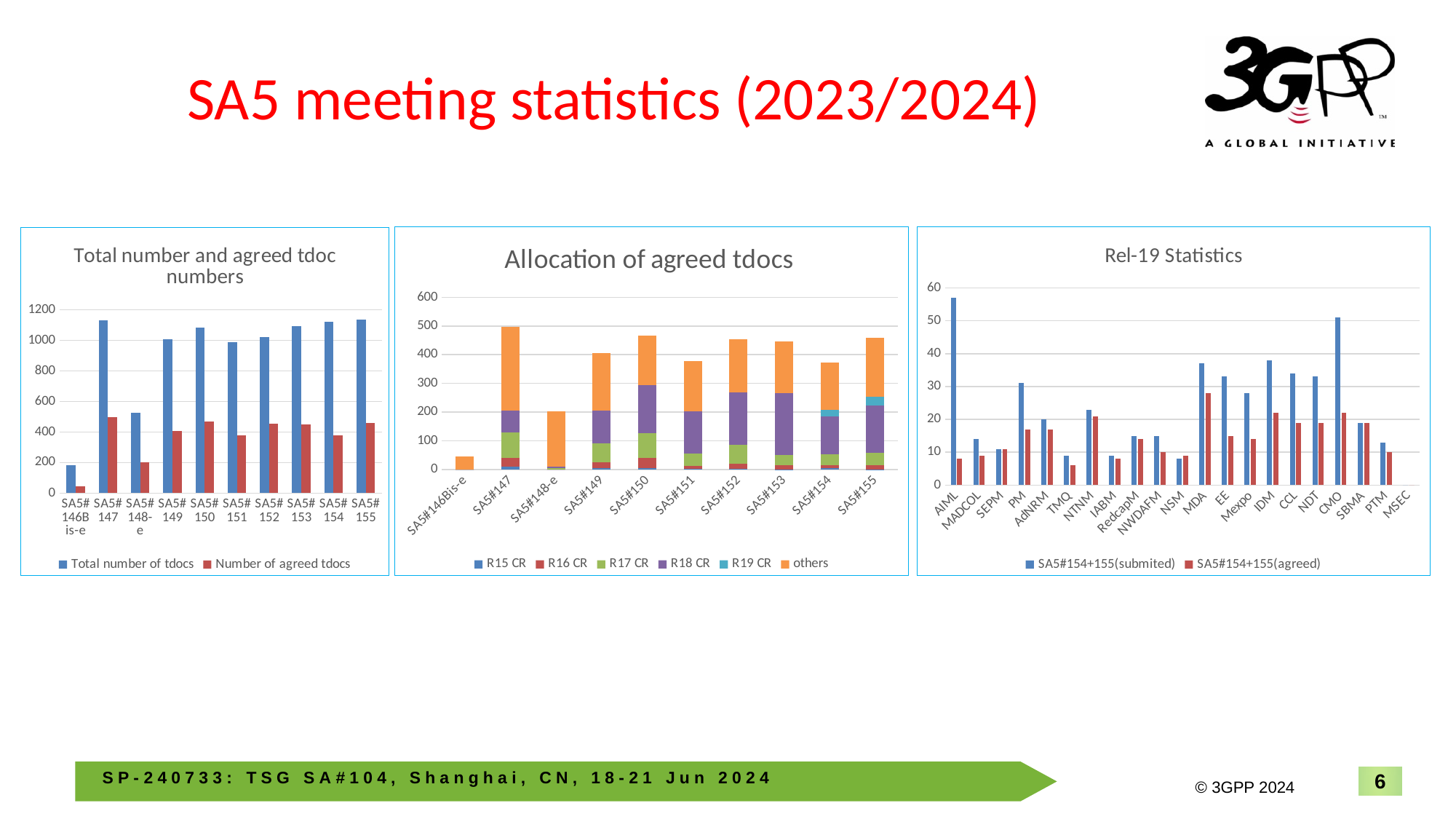
In the chart titled "Rel-19 Statistics", which category has the highest SA5#154+155(submited) value? AIML In the chart titled "Allocation of agreed tdocs", how many series does the legend list? 6 In the chart titled "Total number and agreed tdoc numbers", is the total number of tdocs for SA5#146Bis-e greater or less than 200? less In the chart titled "Allocation of agreed tdocs", which meeting has the lowest stacked total? SA5#146Bis-e What kind of chart is the "Rel-19 Statistics" chart? bar chart In the chart titled "Rel-19 Statistics", which is larger: the SA5#154+155(submited) value for AIML or for CMO? AIML In the chart titled "Total number and agreed tdoc numbers", is the total number of tdocs for SA5#147 greater or less than 1000? greater In the chart titled "Total number and agreed tdoc numbers", how many series does the legend list? 2 In the chart titled "Total number and agreed tdoc numbers", which meeting has the lowest total number of tdocs? SA5#146Bis-e In the chart titled "Allocation of agreed tdocs", is the stacked total for SA5#146Bis-e greater or less than 100? less In the chart titled "Allocation of agreed tdocs", how many meetings are shown on the x axis? 10